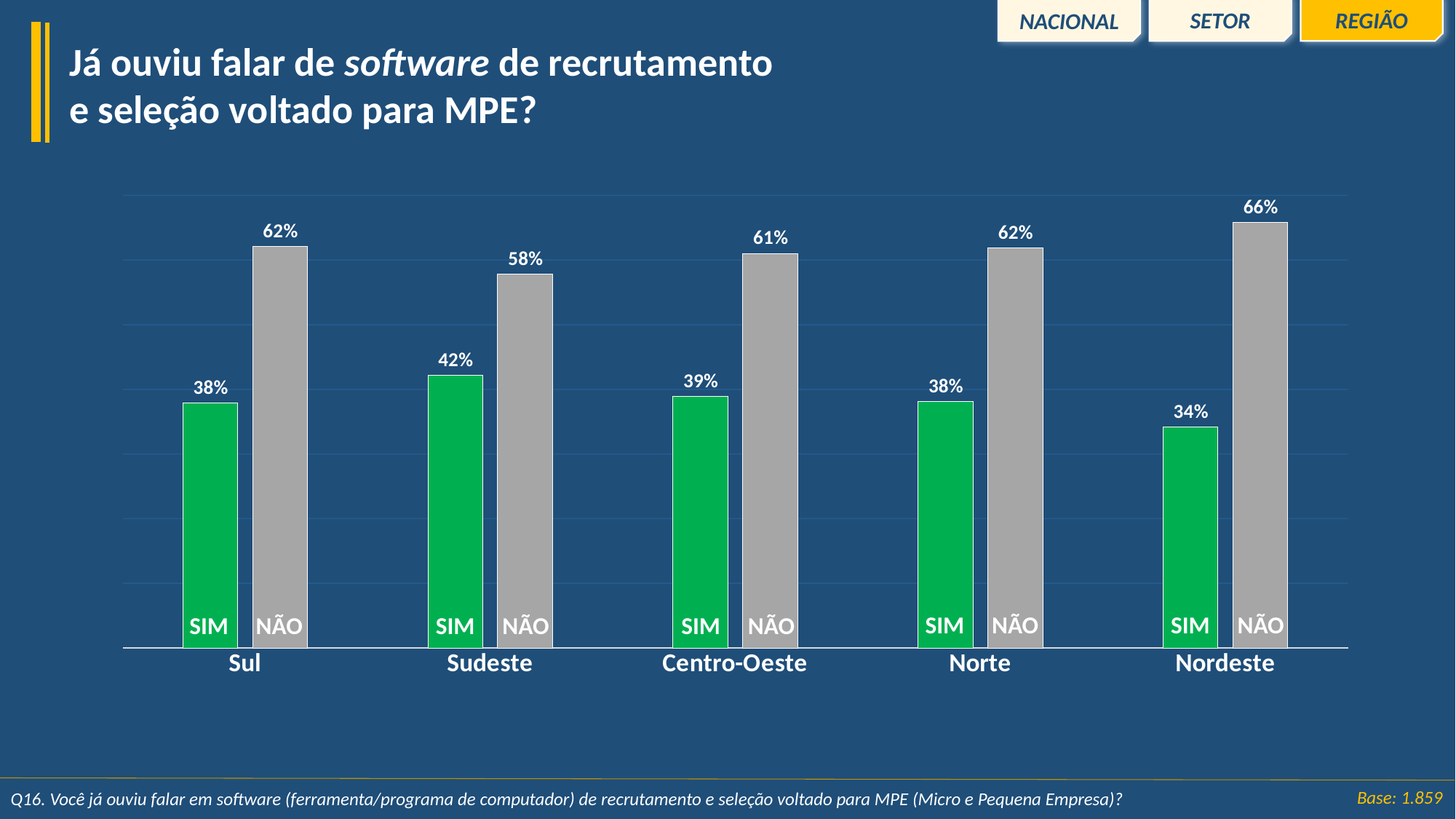
Which is larger, the SIM value for Sudeste or the SIM value for Norte? Sudeste What colour are the SIM bars? Green What is the SIM value for Centro-Oeste? 39% What is the SIM value for Sudeste? 42% What kind of chart is shown on the slide? Bar chart Which region has the highest NÃO value? Nordeste Which region has the lowest SIM value? Nordeste What is the difference between the NÃO and SIM values for Sul? 24% How many series (SIM and NÃO) are plotted for each region? 2 What is the NÃO value for Nordeste? 66% Which region has the highest SIM value? Sudeste How many regions are shown on the x axis? 5